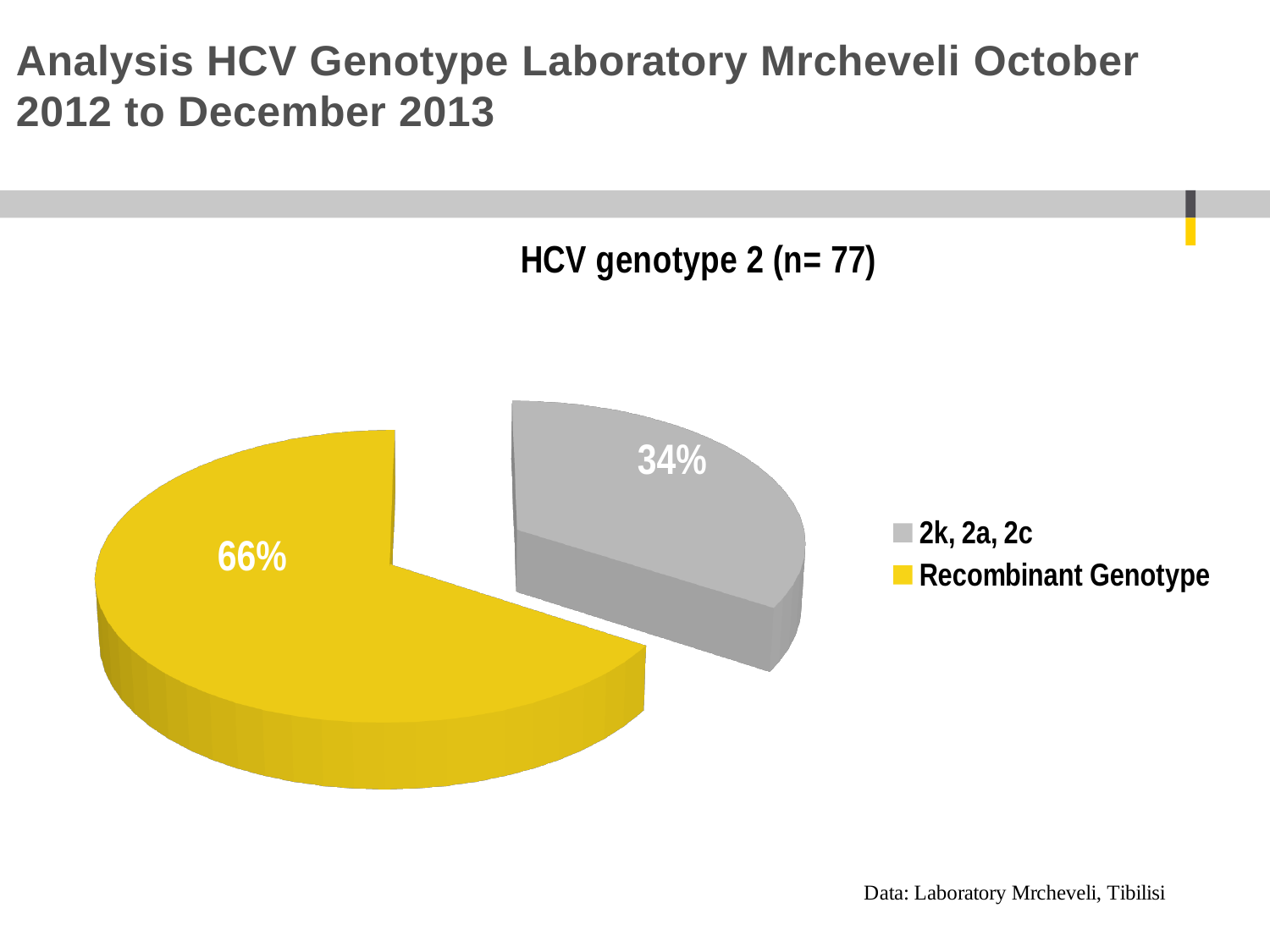
Is the share for 2k, 2a, 2c greater or less than 50%? less What share of the pie is Recombinant Genotype? 66% What kind of chart is shown on the slide? pie chart How many entries does the legend list? 2 What is the difference in percentage points between the Recombinant Genotype slice and the 2k, 2a, 2c slice? 32 Which category has the smallest slice of the pie? 2k, 2a, 2c What colour is the Recombinant Genotype slice? yellow Which is larger: the 2k, 2a, 2c slice or the Recombinant Genotype slice? Recombinant Genotype How many slices does the pie chart have? 2 What is the chart's title? HCV genotype 2 (n= 77) Which category has the largest slice of the pie? Recombinant Genotype What share of the pie is 2k, 2a, 2c? 34%